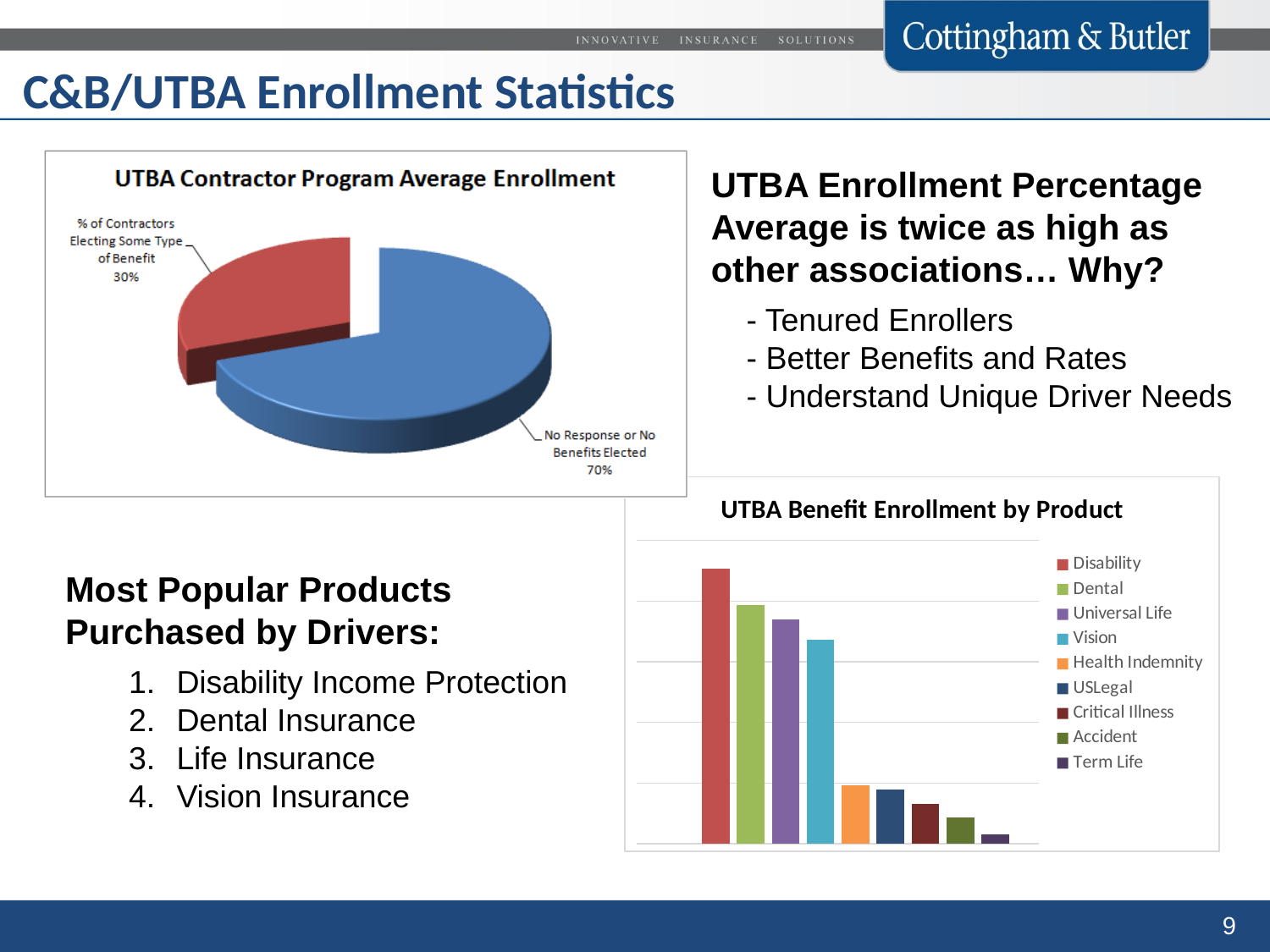
In the UTBA Benefit Enrollment by Product chart, what colour is the Disability bar? Red How many series does the legend of the UTBA Benefit Enrollment by Product chart list? 9 What kind of chart is the UTBA Contractor Program Average Enrollment chart? Pie chart In the UTBA Benefit Enrollment by Product chart, which product has the lowest enrollment? Term Life In the UTBA Contractor Program Average Enrollment chart, what is the difference between the No Response or No Benefits Elected slice and the slice for contractors electing some type of benefit? 40% In the UTBA Contractor Program Average Enrollment chart, which slice is the largest? No Response or No Benefits Elected What kind of chart is the UTBA Benefit Enrollment by Product chart? Bar chart In the UTBA Benefit Enrollment by Product chart, which is larger, Dental or Vision? Dental In the UTBA Contractor Program Average Enrollment chart, what percentage of contractors elected some type of benefit? 30% How many slices does the UTBA Contractor Program Average Enrollment pie chart have? 2 In the UTBA Benefit Enrollment by Product chart, which product has the highest enrollment? Disability In the UTBA Contractor Program Average Enrollment chart, what is the value for No Response or No Benefits Elected? 70%